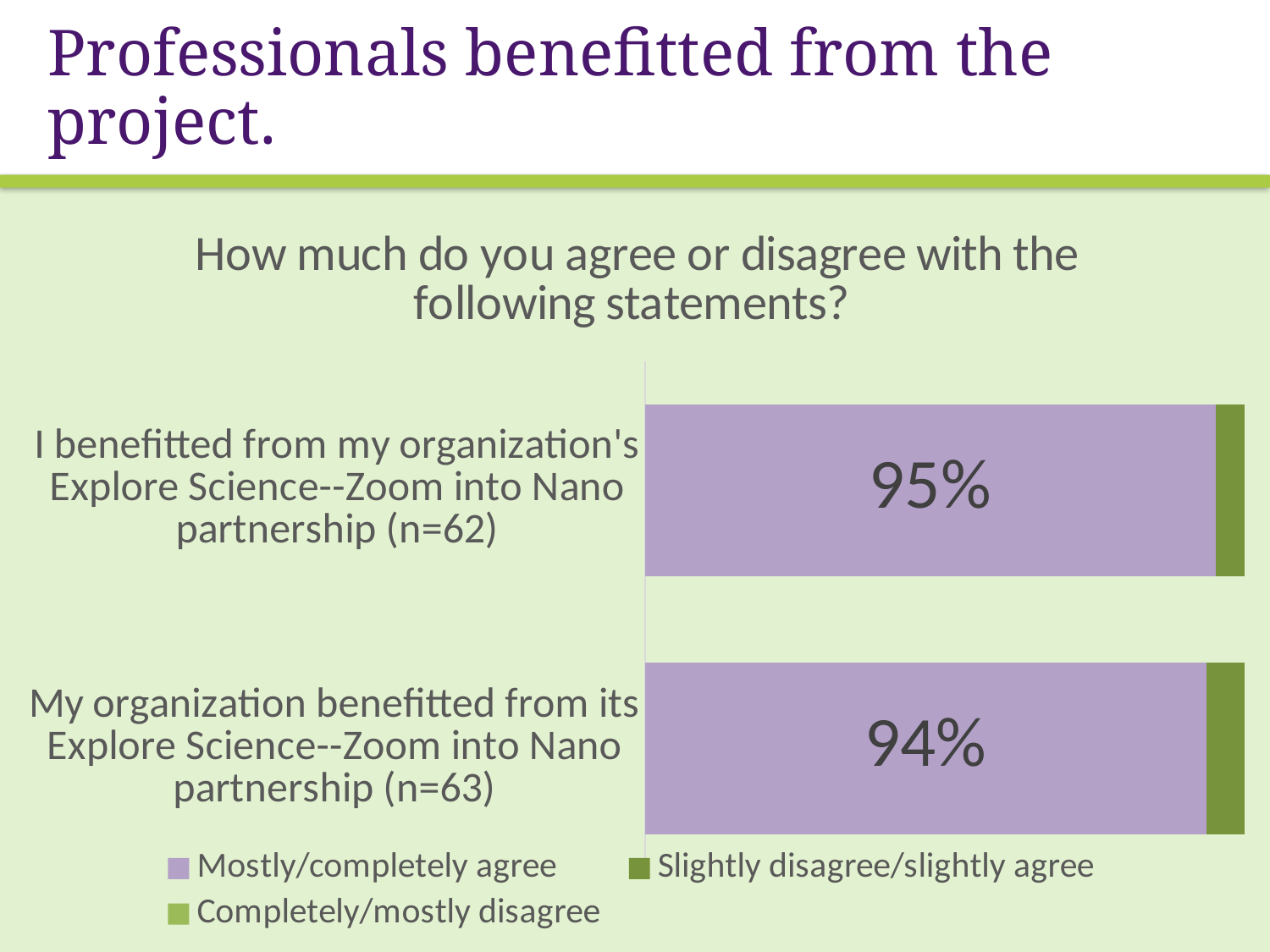
What percentage of respondents mostly or completely agreed with the statement "My organization benefitted from its Explore Science--Zoom into Nano partnership"? 94% Is the "Mostly/completely agree" share larger for "I benefitted from my organization's..." or for "My organization benefitted from its..."? I benefitted from my organization's Explore Science--Zoom into Nano partnership What is the difference in percentage points between the "Mostly/completely agree" values for the two statements? 1 percentage point What type of chart is shown on the slide? Stacked bar chart Which legend entry is shown in purple? Mostly/completely agree What is the sample size (n) for the statement "My organization benefitted from its Explore Science--Zoom into Nano partnership"? n=63 How many series does the chart legend list? 3 How many statements (categories) are shown in the chart? 2 Which statement has the lower share of respondents who mostly or completely agree? My organization benefitted from its Explore Science--Zoom into Nano partnership (n=63) What percentage of respondents mostly or completely agreed with the statement "I benefitted from my organization's Explore Science--Zoom into Nano partnership"? 95% Which statement has the higher share of respondents who mostly or completely agree? I benefitted from my organization's Explore Science--Zoom into Nano partnership (n=62) What is the title of the chart? How much do you agree or disagree with the following statements?